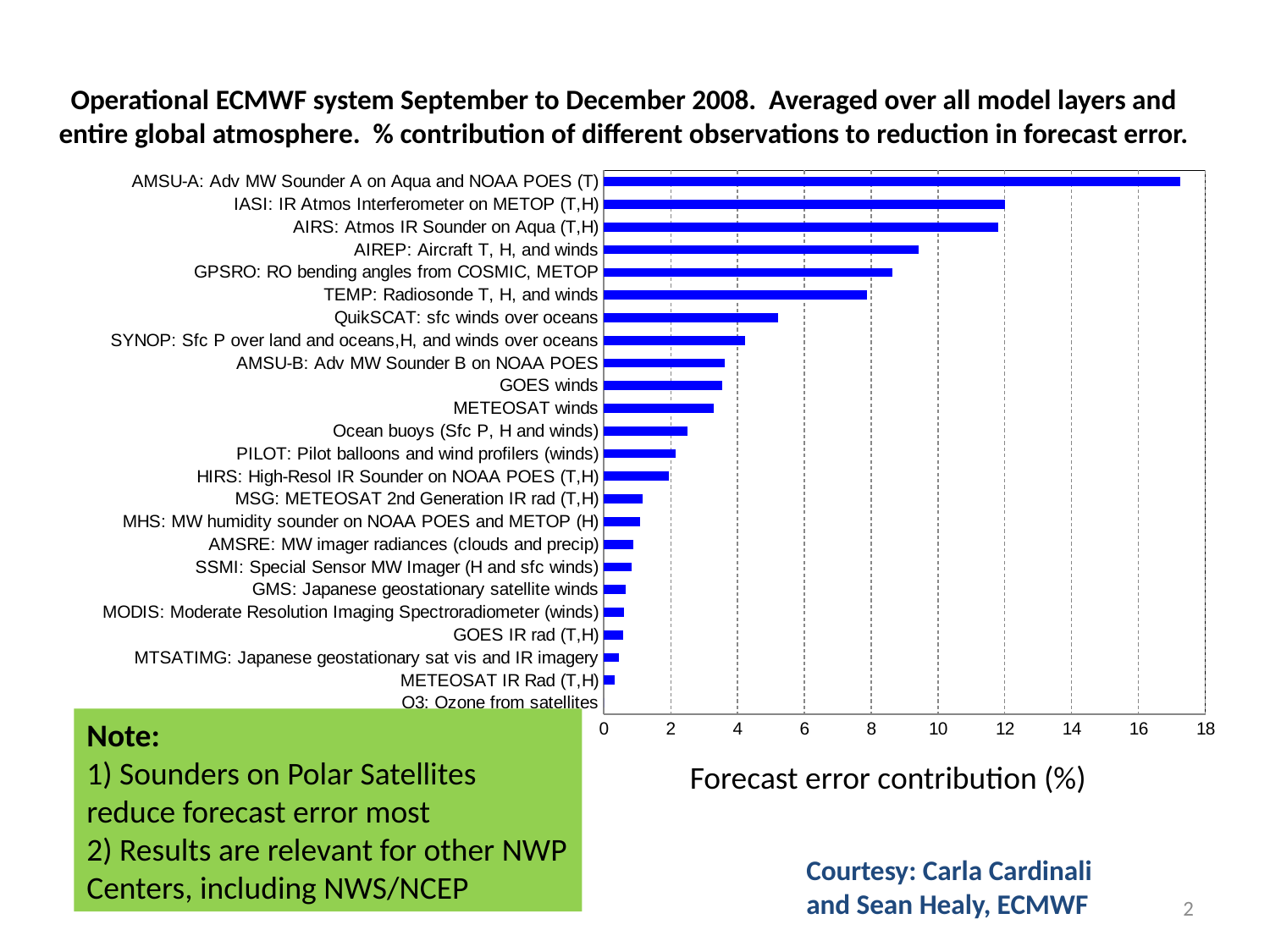
Is the value for AMSU-A greater or less than 16? greater Is the value for AIREP: Aircraft T, H, and winds greater or less than 8? greater How many observation types are listed on the chart? 24 What kind of chart is shown on the slide? bar chart Is the value for Ocean buoys (Sfc P, H and winds) greater or less than 2? greater What is the label of the horizontal axis of the chart? Forecast error contribution (%) Which observation type has the highest forecast error contribution? AMSU-A: Adv MW Sounder A on Aqua and NOAA POES (T) Which observation type has the lowest forecast error contribution? O3: Ozone from satellites Which has a larger forecast error contribution, AIREP or TEMP? AIREP Which has a larger forecast error contribution, QuikSCAT or SYNOP? QuikSCAT